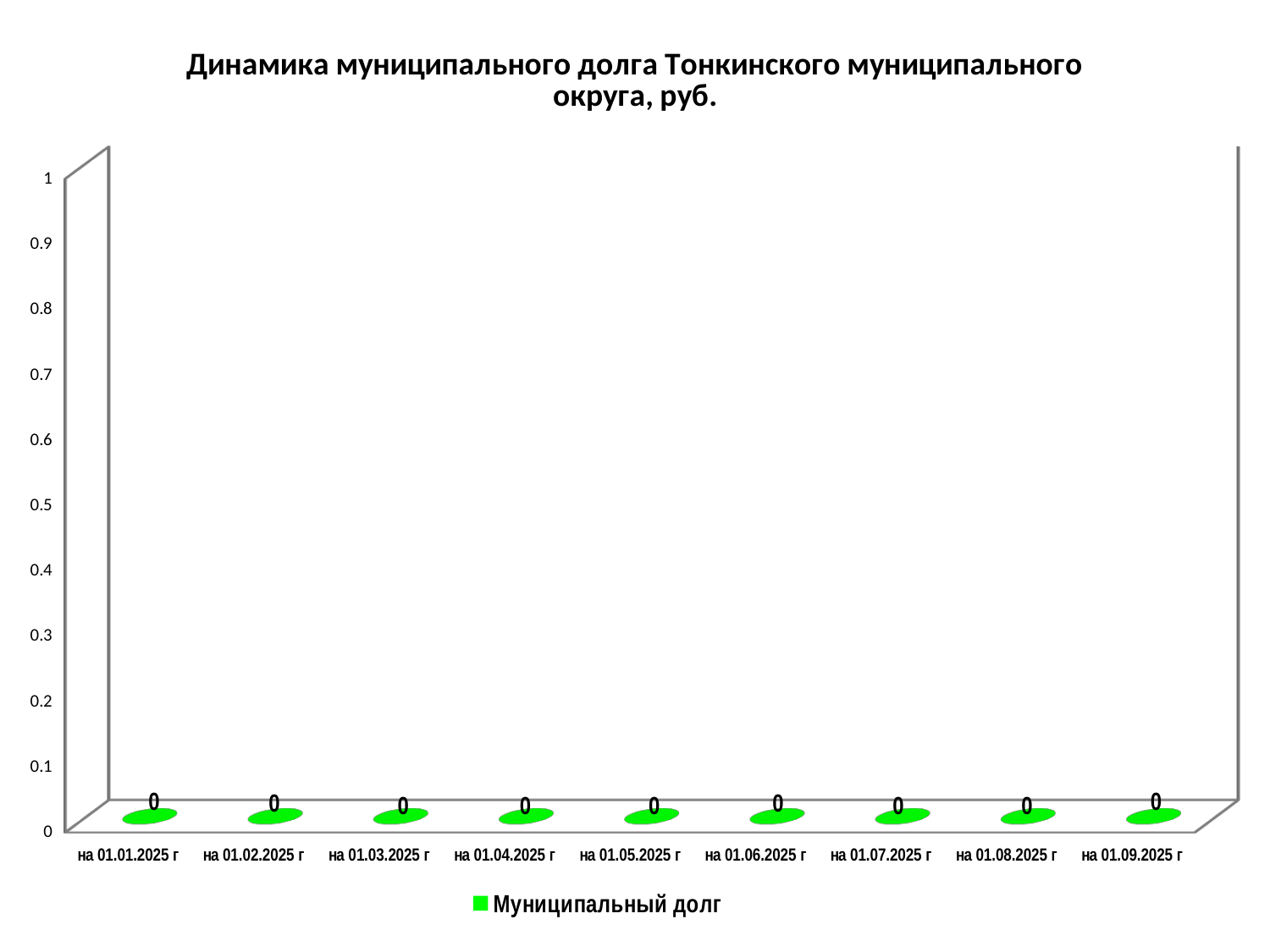
How many dates (categories) are shown on the x axis? 9 How many series does the legend list? 1 What is the value of Муниципальный долг на 01.09.2025 г? 0 What is the title of the chart? Динамика муниципального долга Тонкинского муниципального округа, руб. What is the value of Муниципальный долг на 01.05.2025 г? 0 Do the values rise, fall, or stay the same from 01.01.2025 to 01.09.2025? stay the same What is the difference between the values на 01.03.2025 г and на 01.07.2025 г? 0 What kind of chart is shown on the slide? bar chart What is the value of Муниципальный долг на 01.01.2025 г? 0 What series name is shown in the legend? Муниципальный долг Is the value for на 01.06.2025 г greater or less than 0.5? less